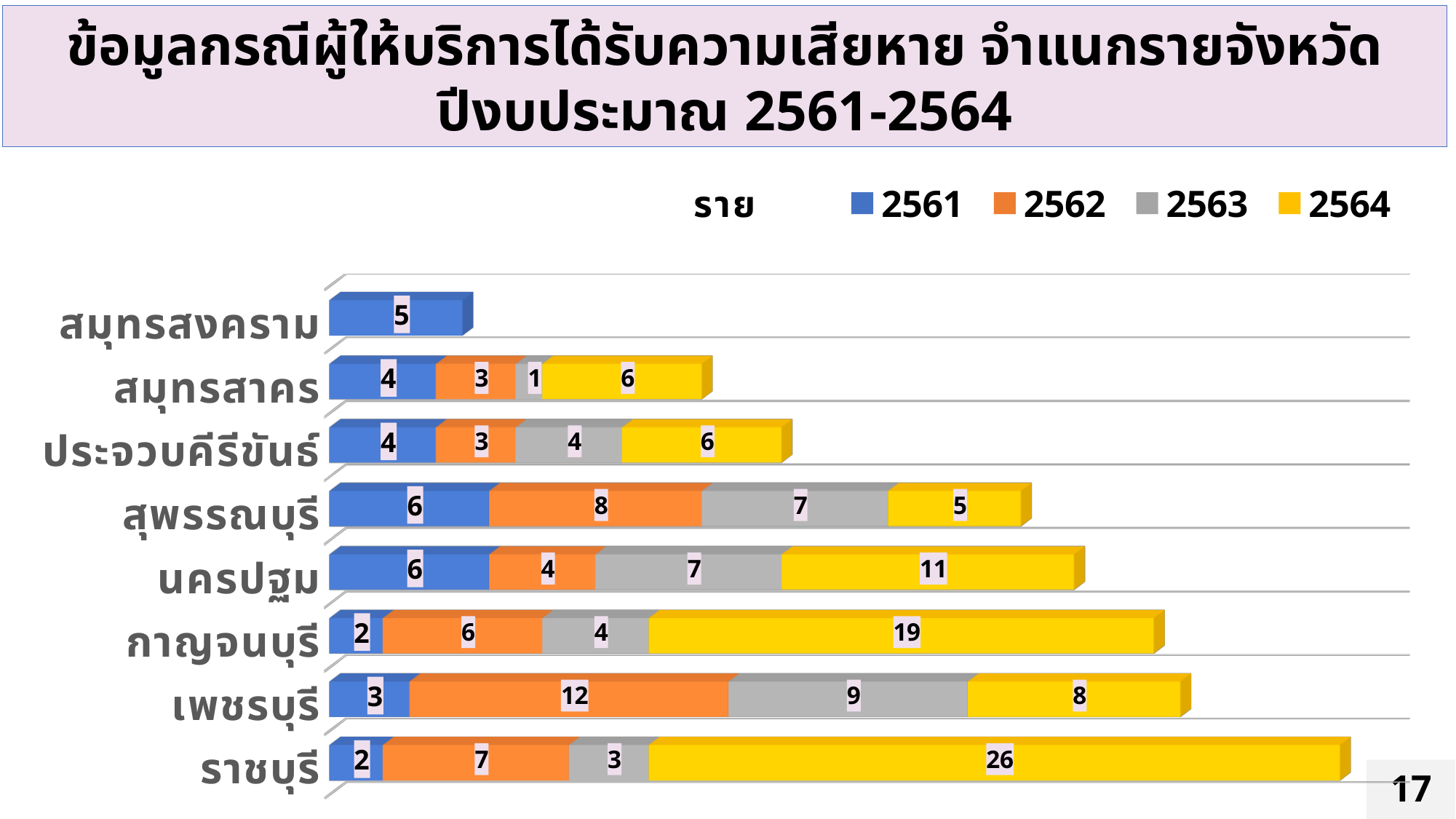
How many provinces (categories) are shown on the chart? 8 What kind of chart is shown on the slide? Stacked bar chart What is the difference between the 2564 values for กาญจนบุรี and นครปฐม? 8 What is the value for ราชบุรี in 2564? 26 What is the value for เพชรบุรี in 2562? 12 What is the total of the stacked bar for ราชบุรี? 38 What is the value for สมุทรสงคราม in 2561? 5 Which province has the lowest value in 2563 among those with a 2563 value? สมุทรสาคร How many series does the legend list? 4 What is the total of the stacked bar for สุพรรณบุรี? 26 Which is larger: the 2562 value for เพชรบุรี or the 2562 value for สุพรรณบุรี? เพชรบุรี Which province has the highest value in 2564? ราชบุรี